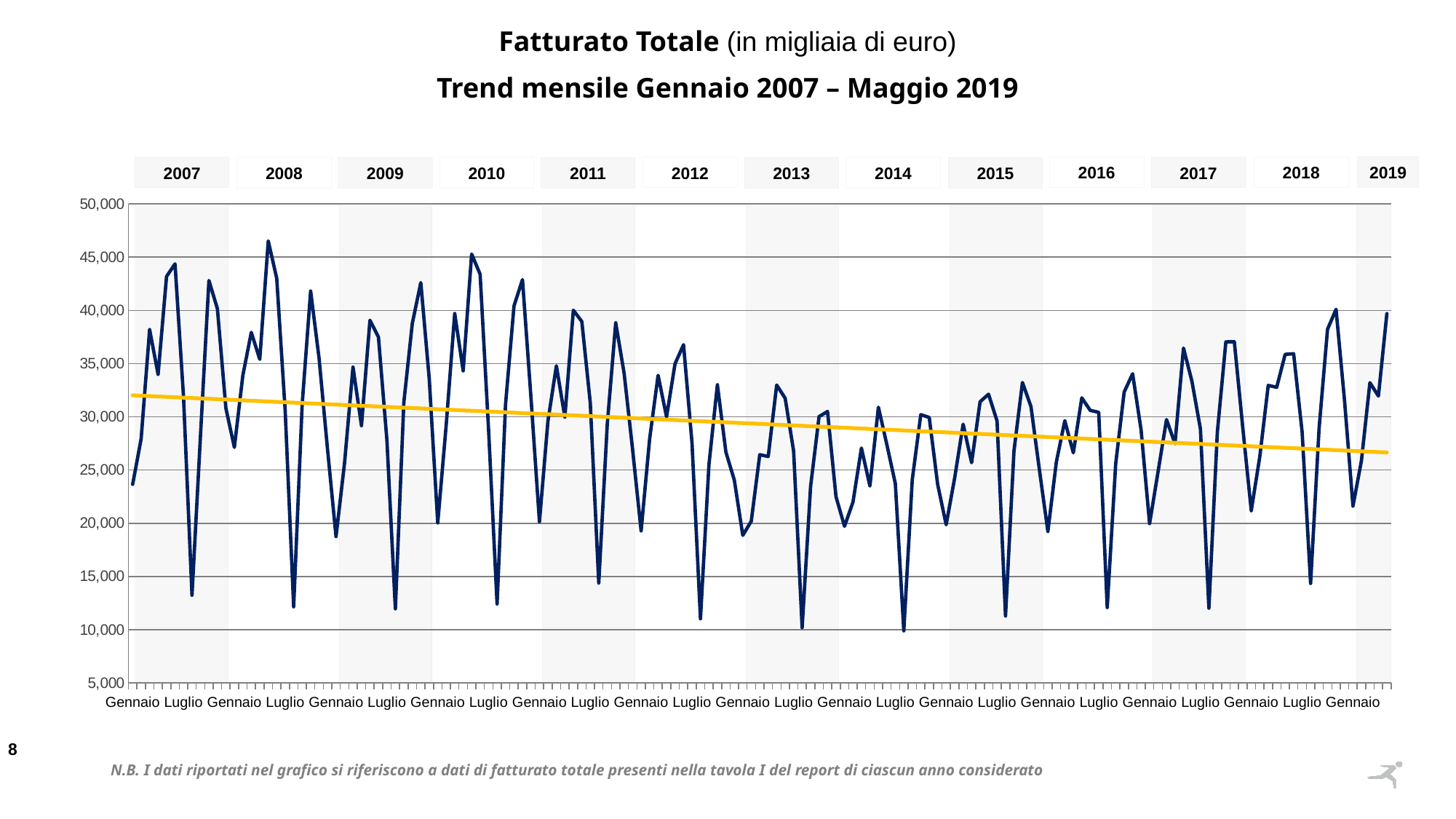
Is the highest peak in 2008 greater or less than 45,000? greater In which year does the line reach its lowest point? 2014 Does the yellow trend line rise or fall from 2007 to 2019? fall What is the title of the chart? Fatturato Totale (in migliaia di euro) Is the yellow trend line at the start of 2007 greater or less than 30,000? greater Is the lowest point in 2014 greater or less than 15,000? less How many year labels are shown above the chart? 13 What period does the monthly trend cover according to the subtitle? Gennaio 2007 – Maggio 2019 In which year does the line reach its highest peak? 2008 What kind of chart is shown on the slide? line chart Which is larger, the highest peak in 2008 or the highest peak in 2014? 2008